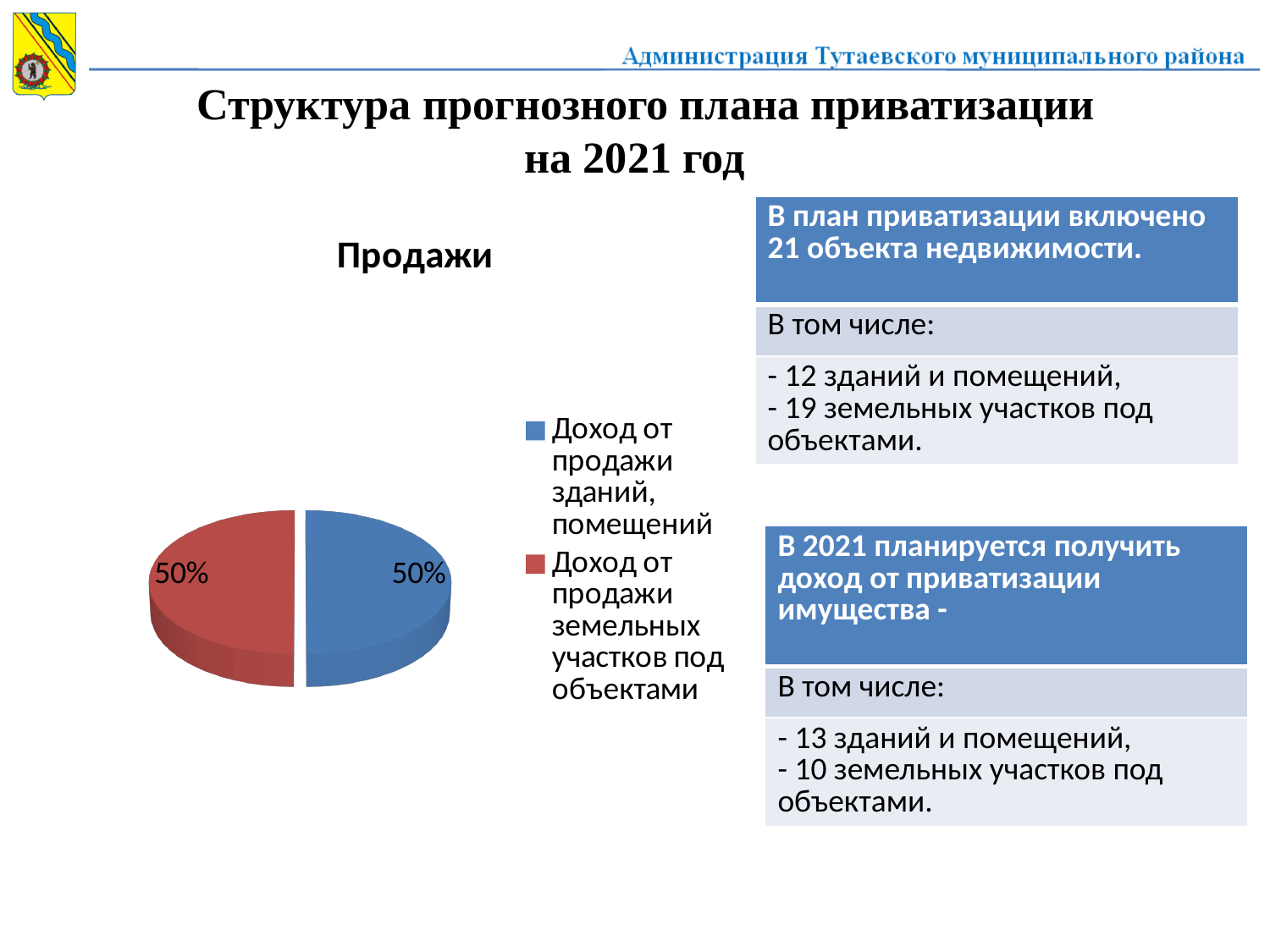
What kind of chart is shown on the slide? pie chart What value is labelled on the red slice of the pie chart? 50% What share of the pie does "Доход от продажи земельных участков под объектами" take? 50% How many entries does the legend of the pie chart list? 2 What is the total of the two slice labels shown on the pie chart? 100% What is the difference between the shares of the two slices in the pie chart? 0% What is the title of the pie chart? Продажи Which colour represents "Доход от продажи земельных участков под объектами" in the pie chart? red What value is labelled on the blue slice of the pie chart? 50% What share of the pie does "Доход от продажи зданий, помещений" take? 50% How many slices does the pie chart have? 2